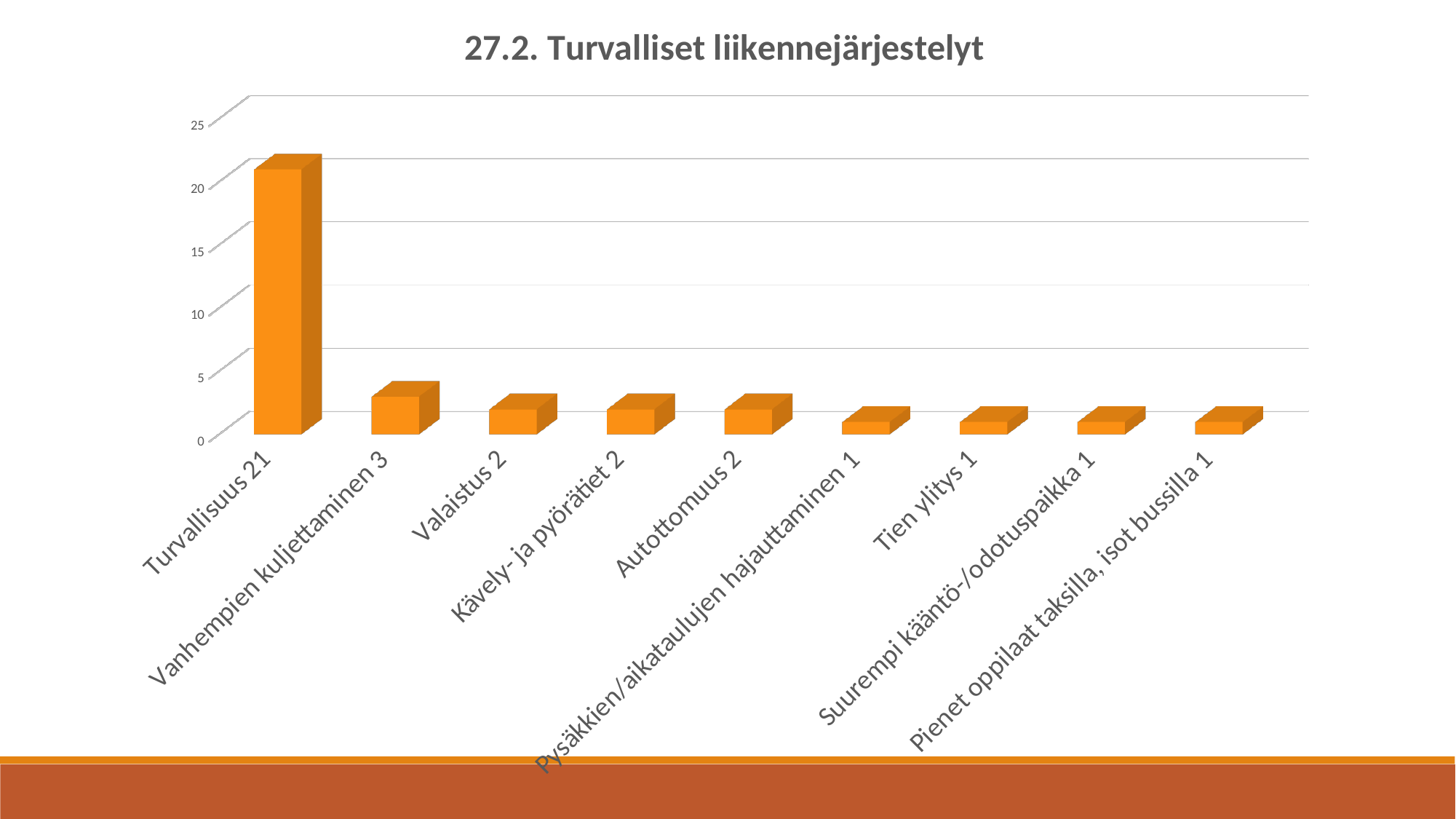
Is the value for Turvallisuus greater or less than 20? greater What is the title of the chart? 27.2. Turvalliset liikennejärjestelyt Do the values rise or fall from left to right along the x axis? fall Which is larger, the value for Vanhempien kuljettaminen or the value for Autottomuus? Vanhempien kuljettaminen What value is shown for Tien ylitys? 1 What value is shown for Vanhempien kuljettaminen? 3 How many categories are shown on the x axis? 9 What value is shown for Valaistus? 2 What is the difference between the values for Turvallisuus and Vanhempien kuljettaminen? 18 What value is shown for Turvallisuus? 21 What kind of chart is shown on the slide? bar chart Which category has the highest value? Turvallisuus